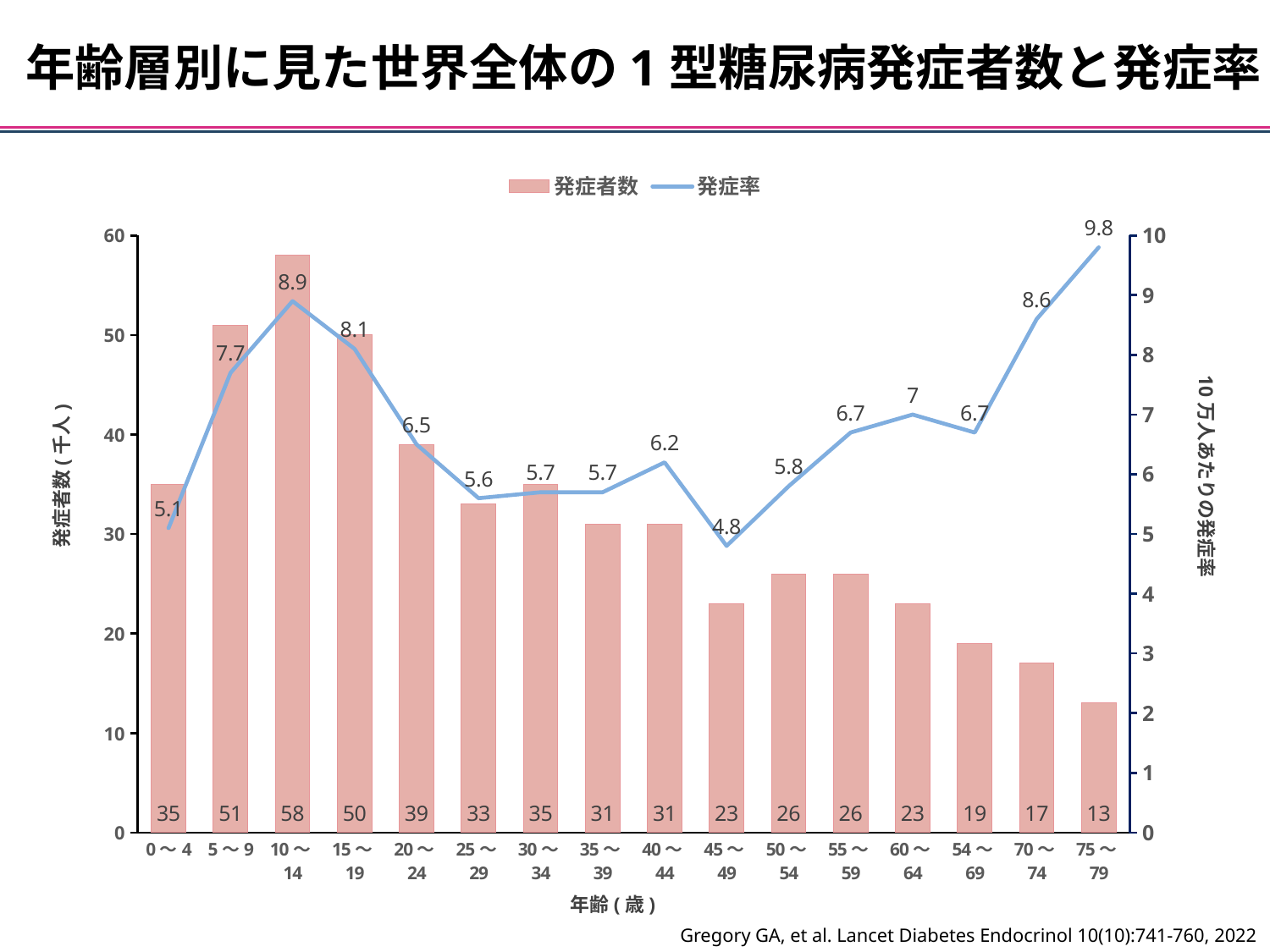
What is the 発症率 value for the 75～79 age group? 9.8 Which age group has the highest 発症者数? 10～14 How many age groups are shown on the x axis? 16 How many series does the legend list? 2 Which age group has the lowest 発症者数? 75～79 Does the 発症者数 rise or fall from the 40～44 age group to the 75～79 age group? Fall What kind of chart is this? Combined bar and line chart Which is larger, the 発症率 for 15～19 or for 70～74? 70～74 What is the 発症者数 value for the 10～14 age group? 58 What is the difference in 発症者数 between the 5～9 and 0～4 age groups? 16 What is the label of the right-hand vertical axis? 10万人あたりの発症率 Which age group has the lowest 発症率? 45～49